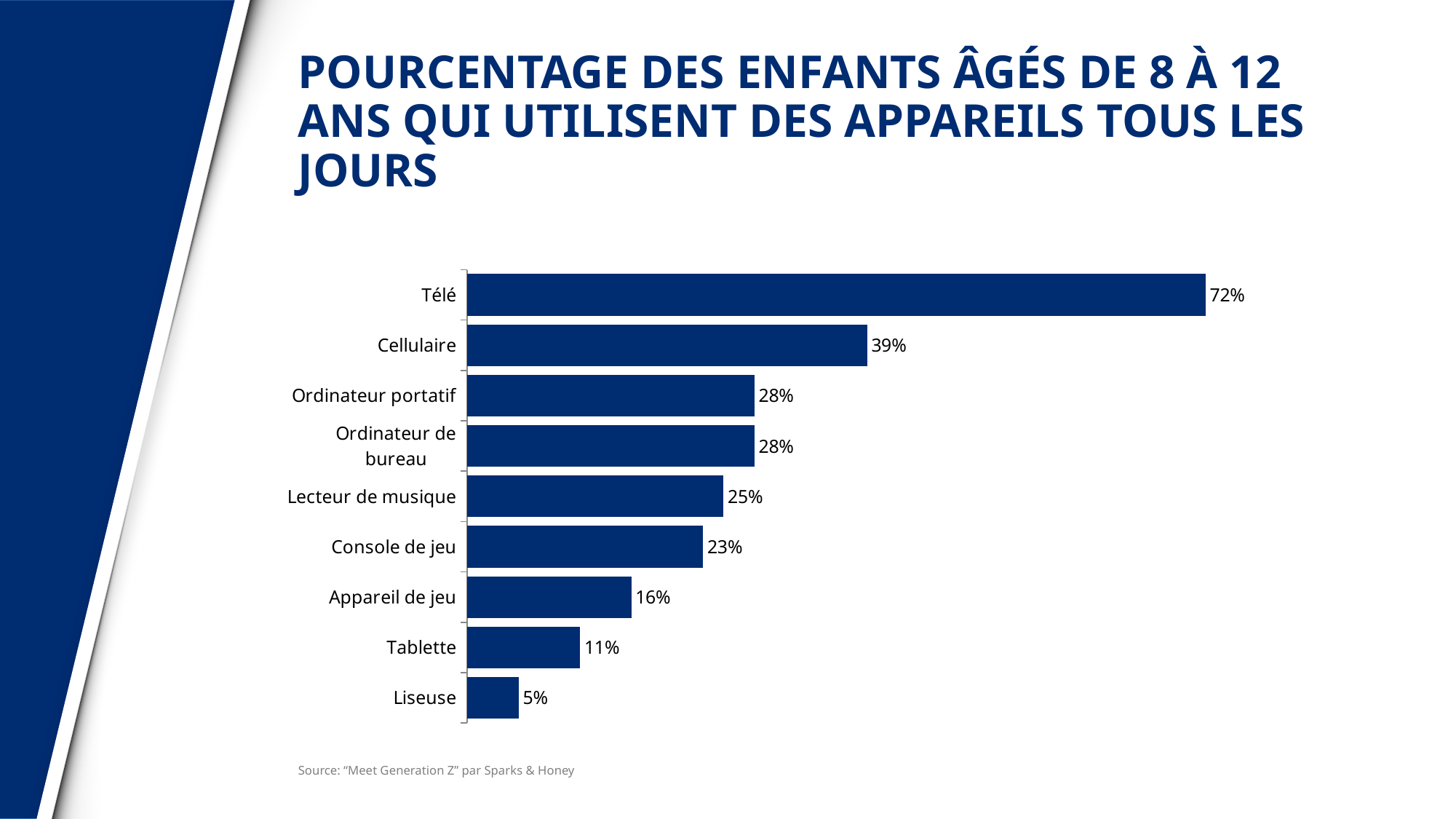
What is the difference between the values for Console de jeu and Appareil de jeu? 7% What source is cited below the chart? "Meet Generation Z" par Sparks & Honey What percentage of children aged 8 to 12 use a Cellulaire every day? 39% Which device has the lowest percentage of daily use? Liseuse Which is larger, the value for Ordinateur portatif or the value for Lecteur de musique? Ordinateur portatif What kind of chart is shown on the slide? Bar chart Which two devices share the same value of 28%? Ordinateur portatif and Ordinateur de bureau How many devices (categories) are shown in the chart? 9 What is the value shown for Lecteur de musique? 25% Which device has the highest percentage of daily use? Télé What is the difference between the values for Télé and Cellulaire? 33% What is the value shown for Tablette? 11%